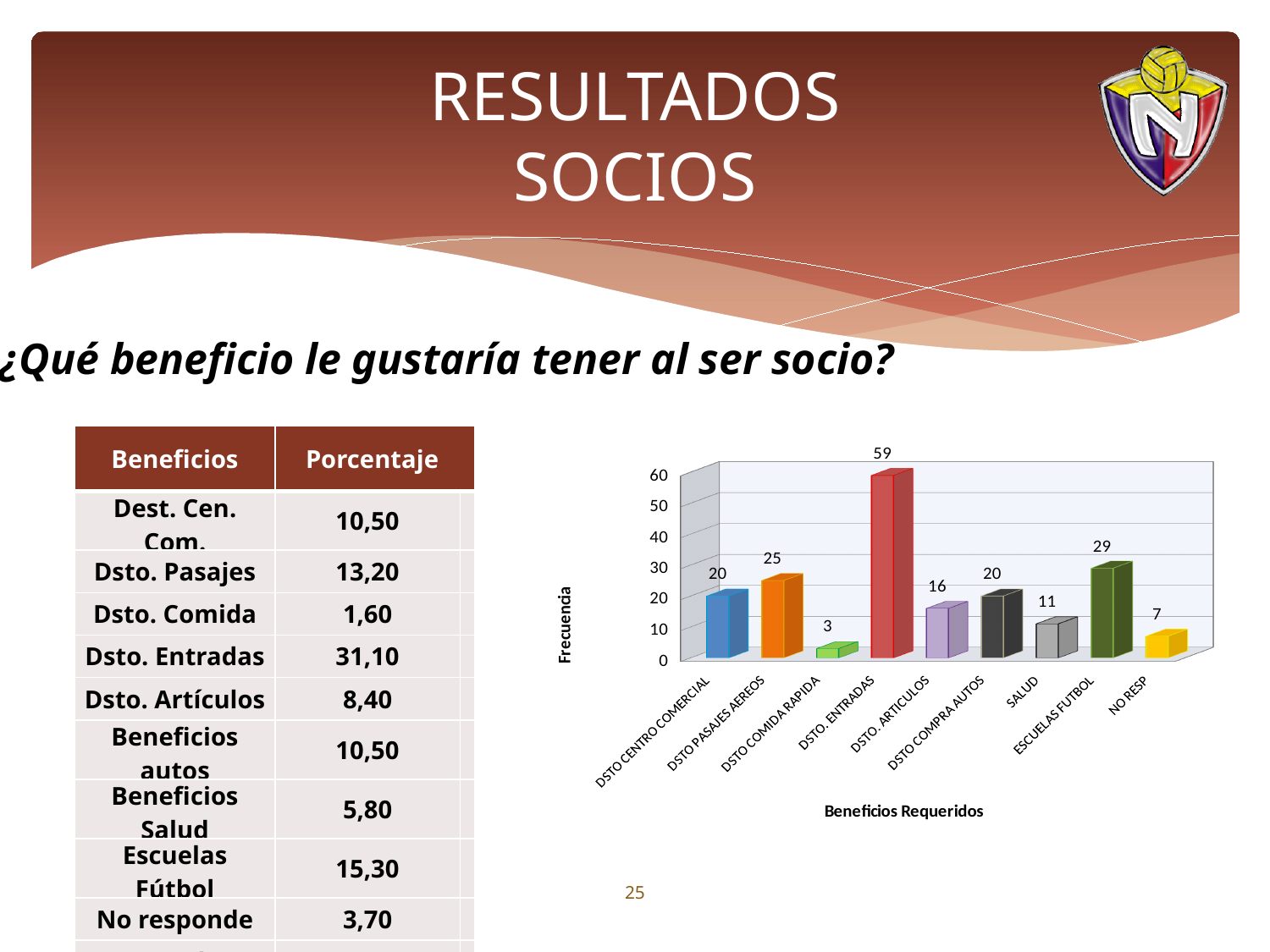
Which category has the highest value in the chart? DSTO. ENTRADAS What is the difference between the values for DSTO. ENTRADAS and ESCUELAS FUTBOL? 30 What kind of chart is shown on the slide? Bar chart What is the label of the vertical axis of the chart? Frecuencia What is the value for SALUD in the chart? 11 What is the value for ESCUELAS FUTBOL in the chart? 29 Which category has the lowest value in the chart? DSTO COMIDA RAPIDA What is the label of the horizontal axis of the chart? Beneficios Requeridos What is the value for DSTO. ENTRADAS in the chart? 59 What is the value for DSTO COMIDA RAPIDA in the chart? 3 Which is larger, the value for DSTO PASAJES AEREOS or the value for DSTO. ARTICULOS? DSTO PASAJES AEREOS How many categories are shown on the x axis of the chart? 9